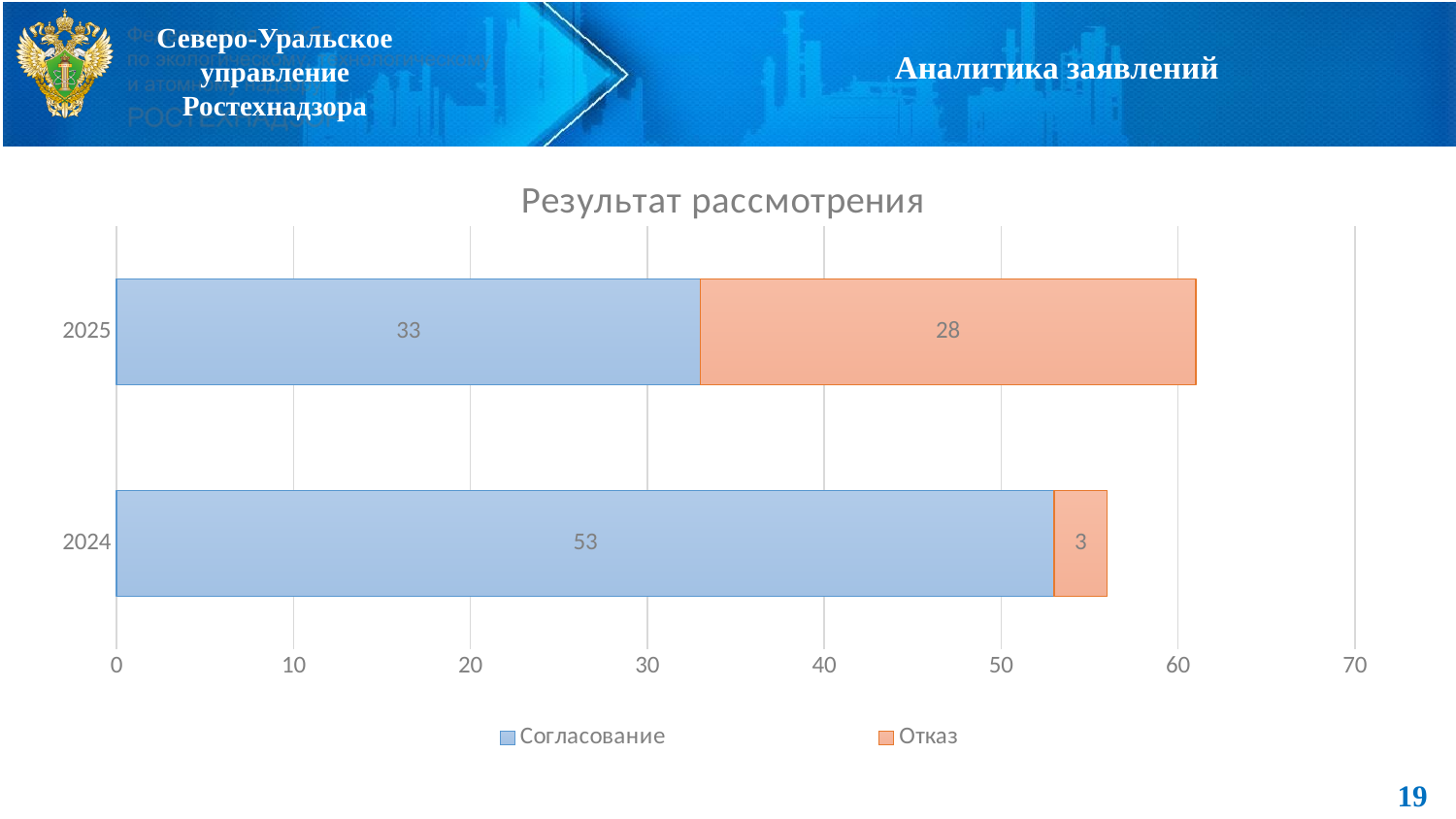
Which year has the higher Согласование value? 2024 What is the value of Согласование for 2024? 53 Is the Отказ value for 2025 larger or smaller than the Отказ value for 2024? larger What is the total of the stacked bar for 2025? 61 Which year has the lower Отказ value? 2024 What is the value of Отказ for 2025? 28 What is the total of the stacked bar for 2024? 56 What is the difference between the Согласование values for 2024 and 2025? 20 What is the value of Согласование for 2025? 33 What is the title of the chart? Результат рассмотрения What is the value of Отказ for 2024? 3 How many series does the legend list? 2